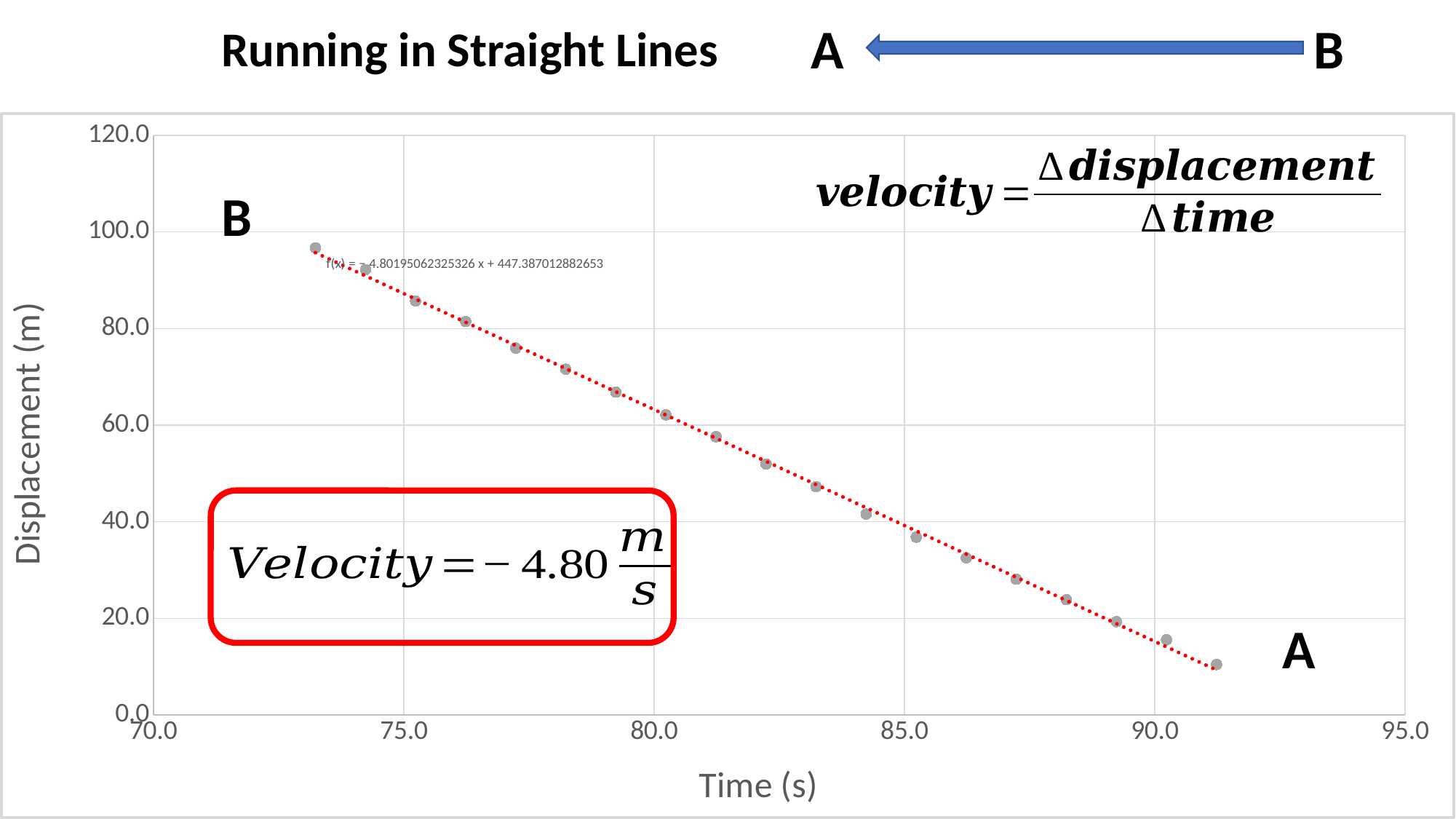
Is the displacement at about 80 s greater or less than 60.0 m? greater How many data points are plotted on the chart? 19 Do the displacement values rise or fall as time increases along the x axis? fall What is the label of the y axis? Displacement (m) What is the maximum value shown on the y axis? 120.0 Which point has the highest displacement, the one labelled B or the one labelled A? B Is the displacement at about 85 s greater or less than 40.0 m? less Is the displacement of the last data point (near 91 s) greater or less than 20.0 m? less What kind of chart is shown on the slide? scatter chart What is the label of the x axis? Time (s) What velocity value is shown in the red box on the chart? -4.80 m/s